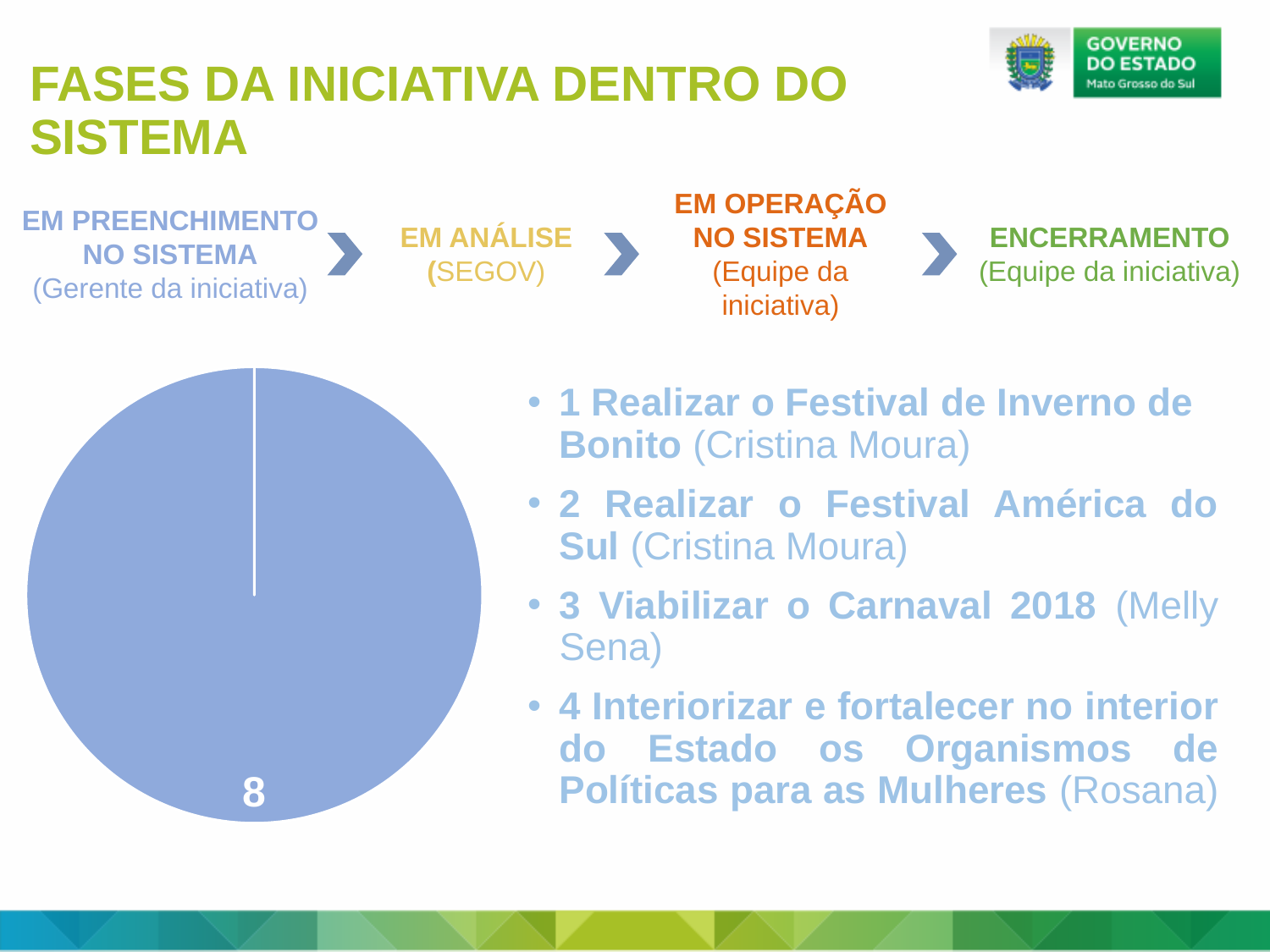
What kind of chart is shown on the left of the slide? pie chart What value is printed as the data label on the pie chart? 8 Does the pie chart display a legend? No How many slices does the pie chart contain? 1 What share of the pie does the slice labelled 8 represent? 100% What colour is the pie chart's slice? blue